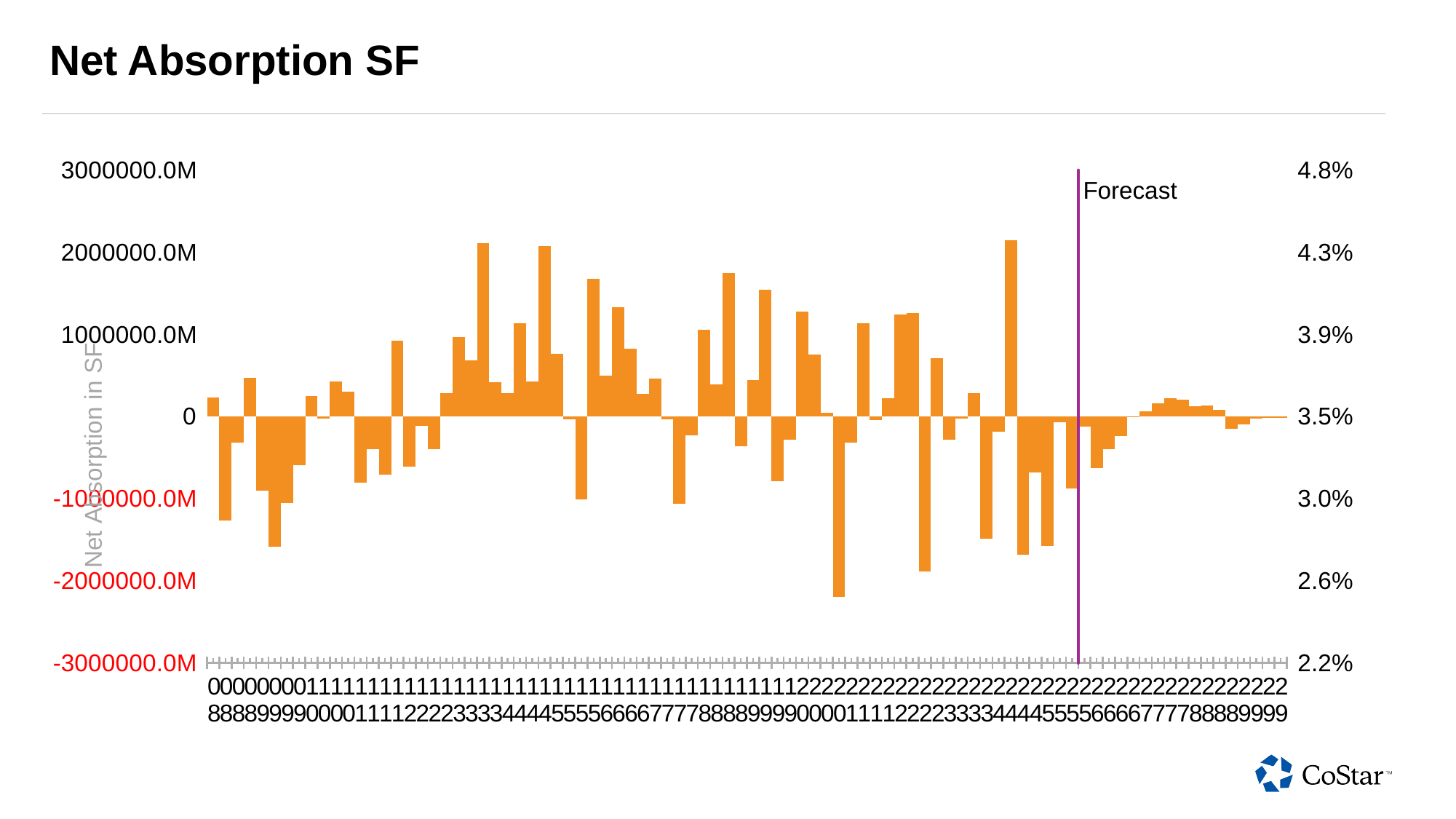
What label is shown next to the vertical purple line in the chart? Forecast What is the lowest value shown on the right vertical axis? 2.2% What is the highest value shown on the right vertical axis? 4.8% What kind of chart is shown on the slide? bar chart Is the value of the lowest (most negative) bar greater or less than -2000000.0M? less What is the lowest value shown on the left vertical axis? -3000000.0M Is the lowest (most negative) bar located before or after the Forecast line? before Is the value of the tallest bar greater or less than 2000000.0M? greater What is the title of the chart? Net Absorption SF What is the highest value shown on the left vertical axis? 3000000.0M